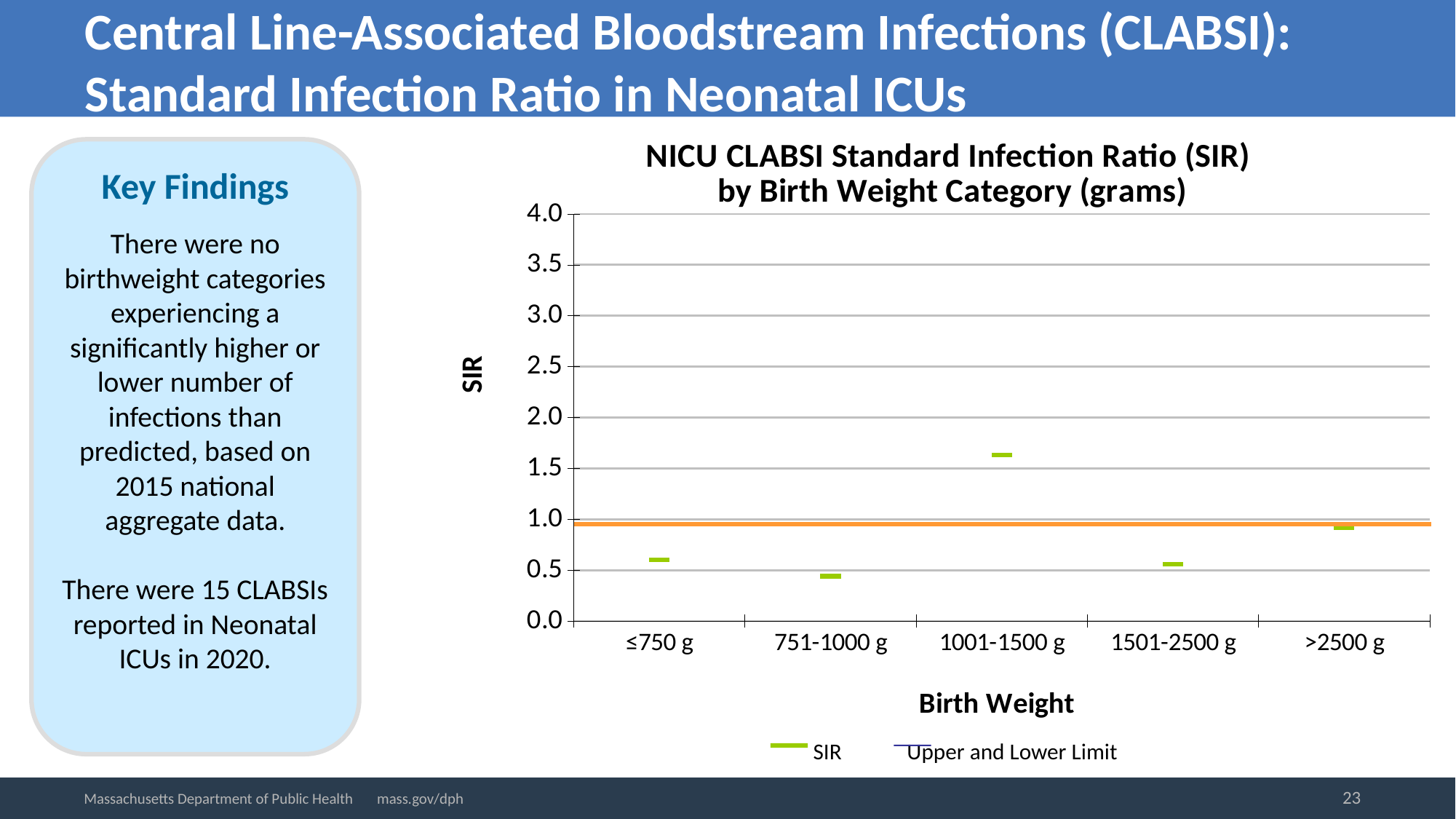
Is the SIR for 1501-2500 g greater or less than 1.0? less Which has a higher SIR, 1001-1500 g or ≤750 g? 1001-1500 g What is the title of the chart? NICU CLABSI Standard Infection Ratio (SIR) by Birth Weight Category (grams) Is the SIR for 1001-1500 g greater or less than 1.5? greater How many birth weight categories are shown on the x axis of the chart? 5 What are the two entries in the chart's legend? SIR; Upper and Lower Limit Which has a higher SIR, >2500 g or 751-1000 g? >2500 g Is the SIR for 751-1000 g greater or less than 0.5? less Which birth weight category has the highest SIR in the chart? 1001-1500 g How many series does the chart's legend list? 2 Which birth weight category has the lowest SIR in the chart? 751-1000 g